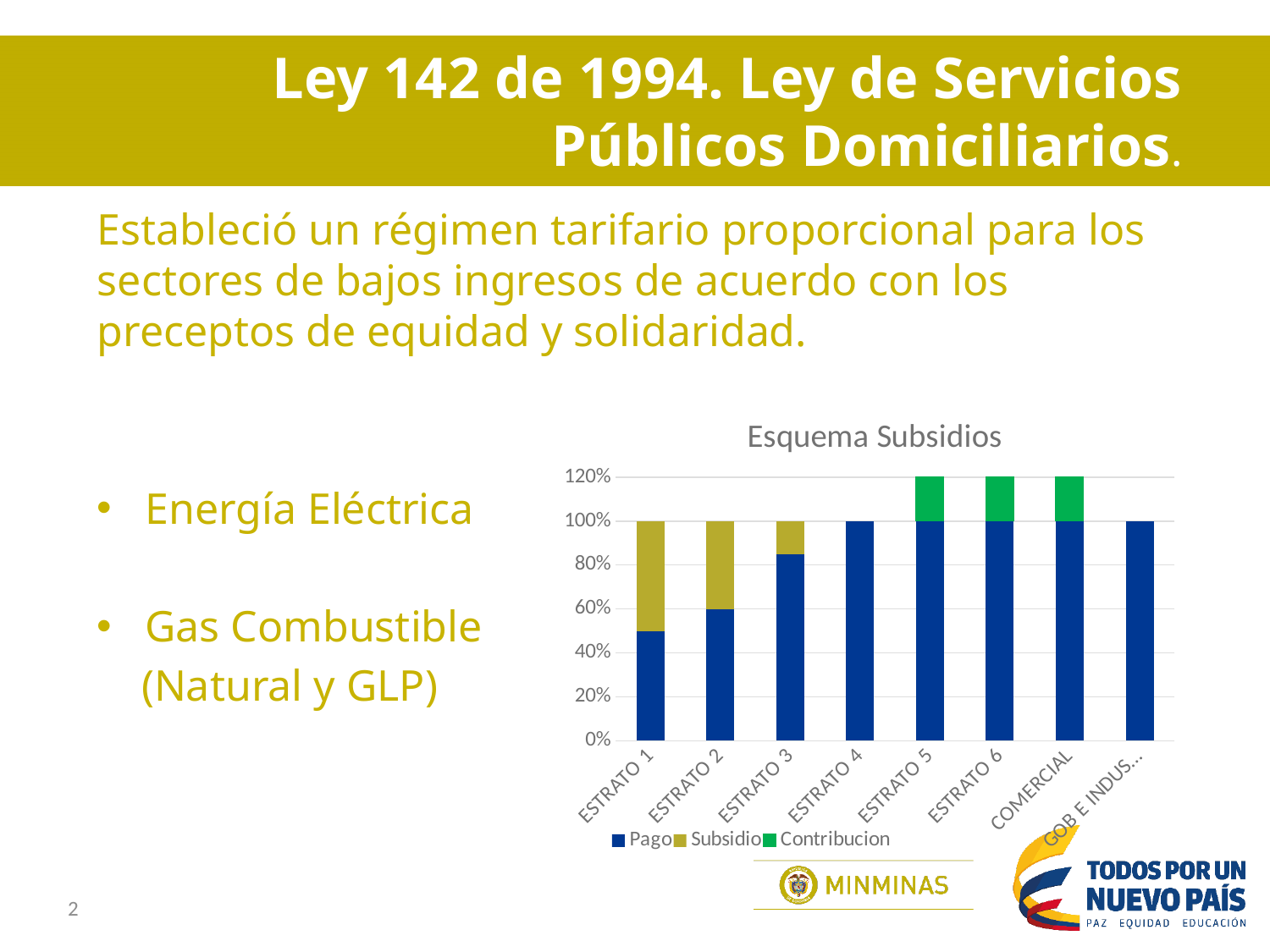
In the "Esquema Subsidios" chart, which has the larger Pago value, ESTRATO 1 or ESTRATO 2? ESTRATO 2 In the "Esquema Subsidios" chart, do the Pago values rise or fall from ESTRATO 1 to ESTRATO 4? rise In the "Esquema Subsidios" chart, what is the Pago value for ESTRATO 4? 100% In the "Esquema Subsidios" chart, is the Pago value for ESTRATO 2 greater or less than 40%? greater How many categories are shown on the x axis of the "Esquema Subsidios" chart? 8 What is the title of the chart on the slide? Esquema Subsidios What kind of chart is shown under the title "Esquema Subsidios"? bar chart In the "Esquema Subsidios" chart, is the Pago value for ESTRATO 1 greater or less than 60%? less In the "Esquema Subsidios" chart, which category has the lowest Pago value? ESTRATO 1 What are the three legend entries of the "Esquema Subsidios" chart? Pago, Subsidio, Contribucion In the "Esquema Subsidios" chart, is the Pago value for ESTRATO 3 greater or less than 80%? greater How many series does the legend of the "Esquema Subsidios" chart list? 3